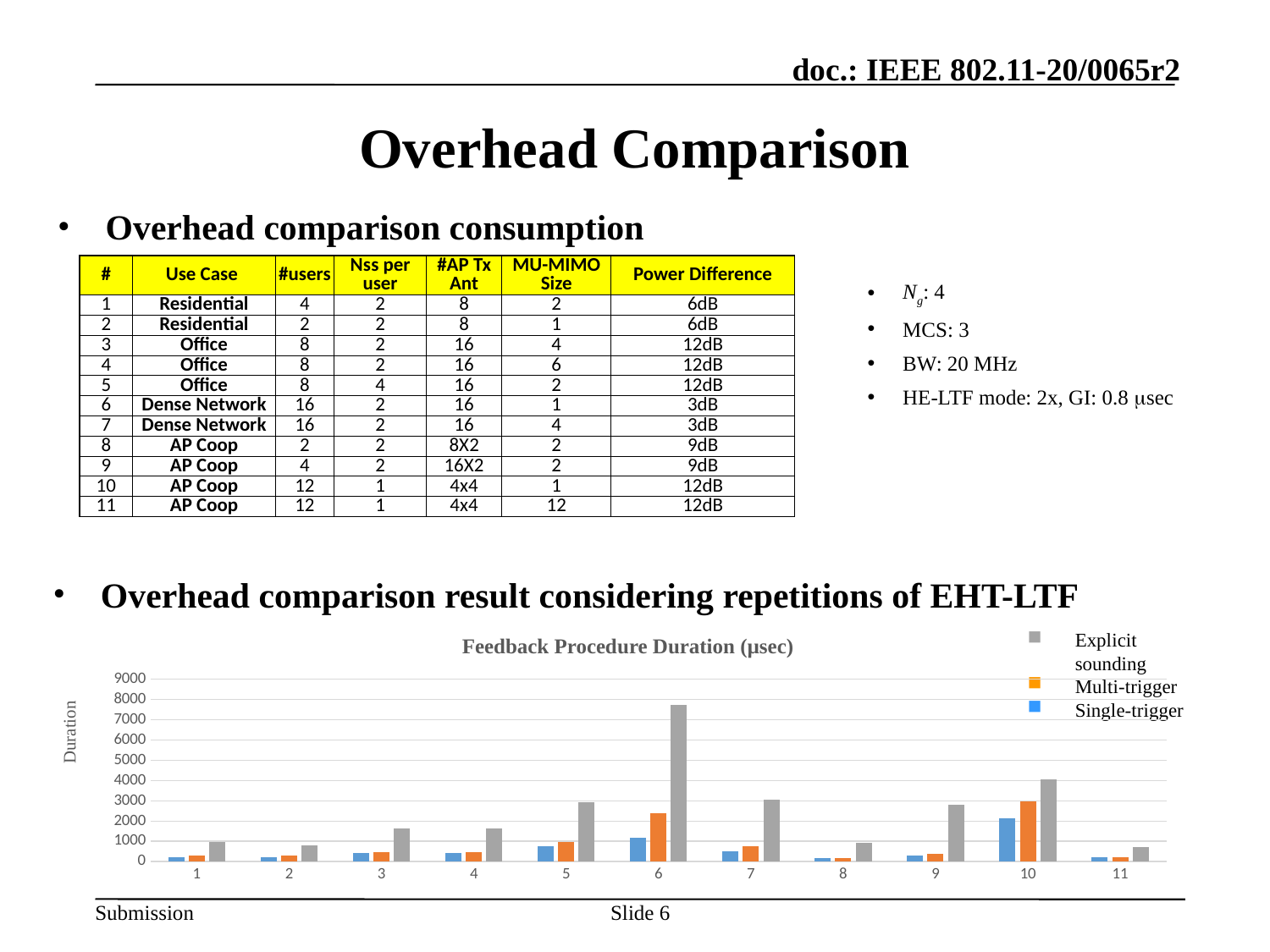
Which category has the highest Explicit sounding value in the chart? 6 Is the Explicit sounding value for category 6 greater or less than 7000? greater How many series does the chart legend list? 3 Which category has the highest Multi-trigger value in the chart? 10 Which colour represents the Explicit sounding series in the chart? gray What kind of chart is shown at the bottom of the slide? bar chart Which is larger: the Explicit sounding value for category 6 or for category 10? category 6 How many categories are shown along the x axis of the chart? 11 Is the Multi-trigger value for category 6 greater or less than 2000? greater Is the Explicit sounding value for category 3 greater or less than 1000? greater Which category has the highest Single-trigger value in the chart? 10 What is the title of the chart on the slide? Feedback Procedure Duration (μsec)